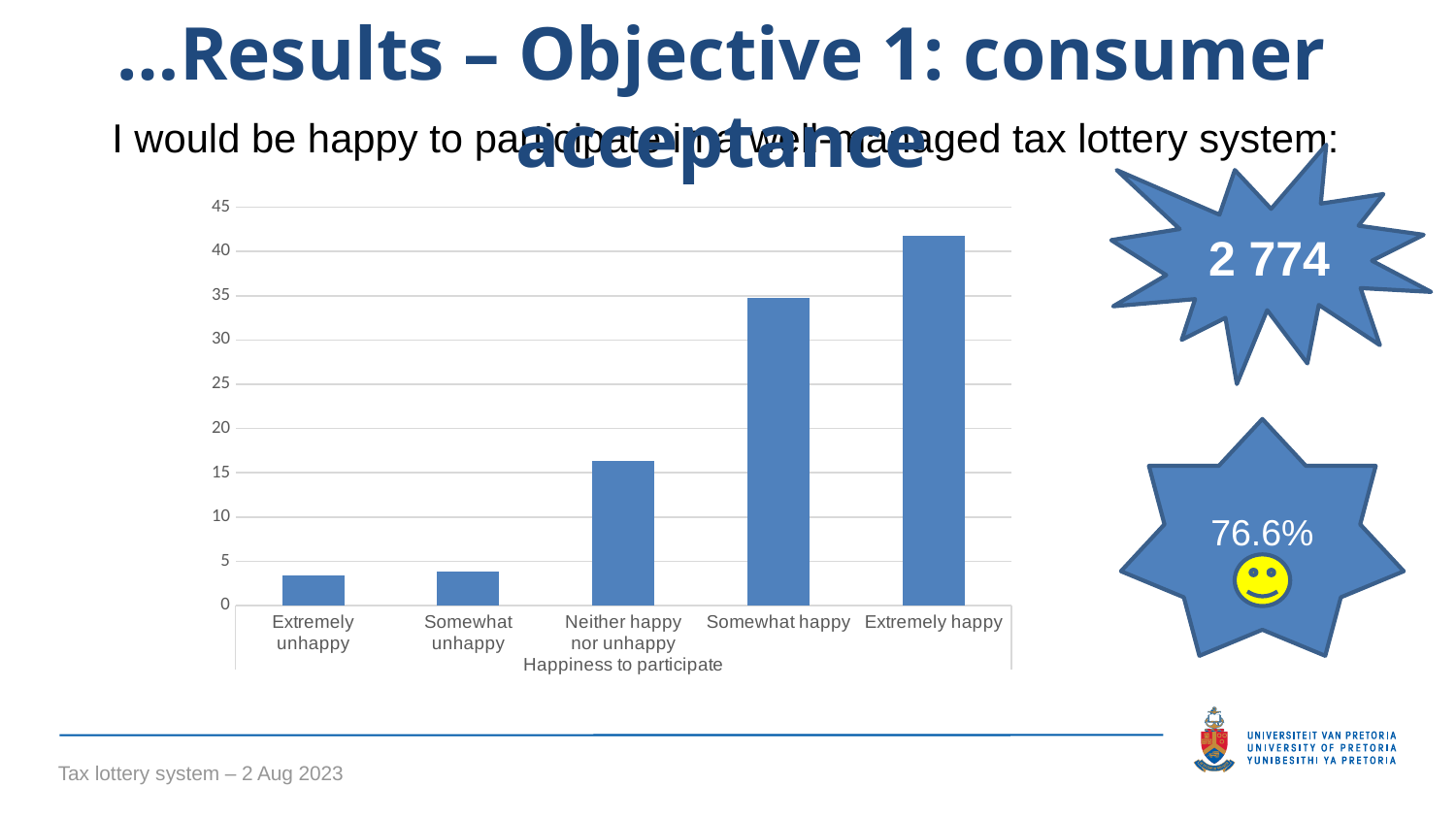
Is the value for Somewhat happy greater or less than 30? greater Is the value for Neither happy nor unhappy greater or less than 20? less How many categories are shown on the x axis of the chart? 5 Is the value for Extremely unhappy greater or less than 5? less What is the title of the x axis of the chart? Happiness to participate Which is larger, the value for Neither happy nor unhappy or the value for Somewhat unhappy? Neither happy nor unhappy Do the bar values rise or fall from left to right along the x axis? rise Which is larger, the value for Somewhat happy or the value for Extremely happy? Extremely happy Which category has the highest bar in the chart? Extremely happy What kind of chart is shown on the slide? bar chart